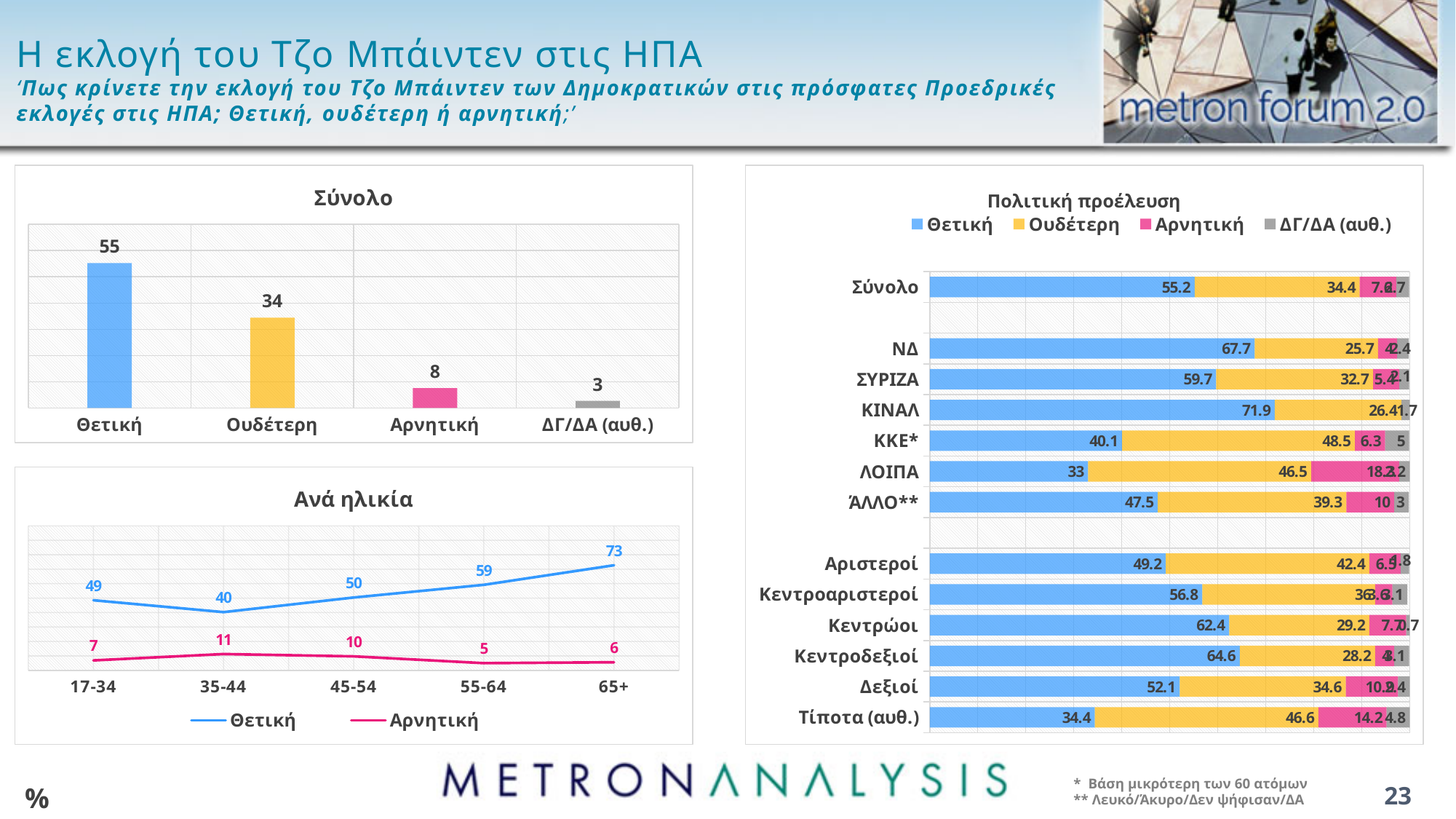
In the 'Πολιτική προέλευση' chart, which is larger, the Θετική value for ΝΔ or for ΣΥΡΙΖΑ? ΝΔ How many series does the legend of the 'Πολιτική προέλευση' chart list? 4 In the 'Σύνολο' chart, what is the value for Θετική? 55 How many series does the legend of the 'Ανά ηλικία' chart list? 2 In the 'Πολιτική προέλευση' chart, what is the Ουδέτερη value for ΚΚΕ*? 48.5 In the 'Ανά ηλικία' chart, how many age groups are shown on the x axis? 5 In the 'Ανά ηλικία' chart, which age group has the highest Αρνητική value? 35-44 In the 'Ανά ηλικία' chart, what is the Θετική value for the 65+ age group? 73 In the 'Πολιτική προέλευση' chart, what is the Θετική value for ΚΙΝΑΛ? 71.9 In the 'Σύνολο' chart, which category has the lowest value? ΔΓ/ΔΑ (αυθ.) In the 'Σύνολο' chart, what is the difference between Θετική and Ουδέτερη? 21 What kind of chart is the 'Σύνολο' chart? Bar chart